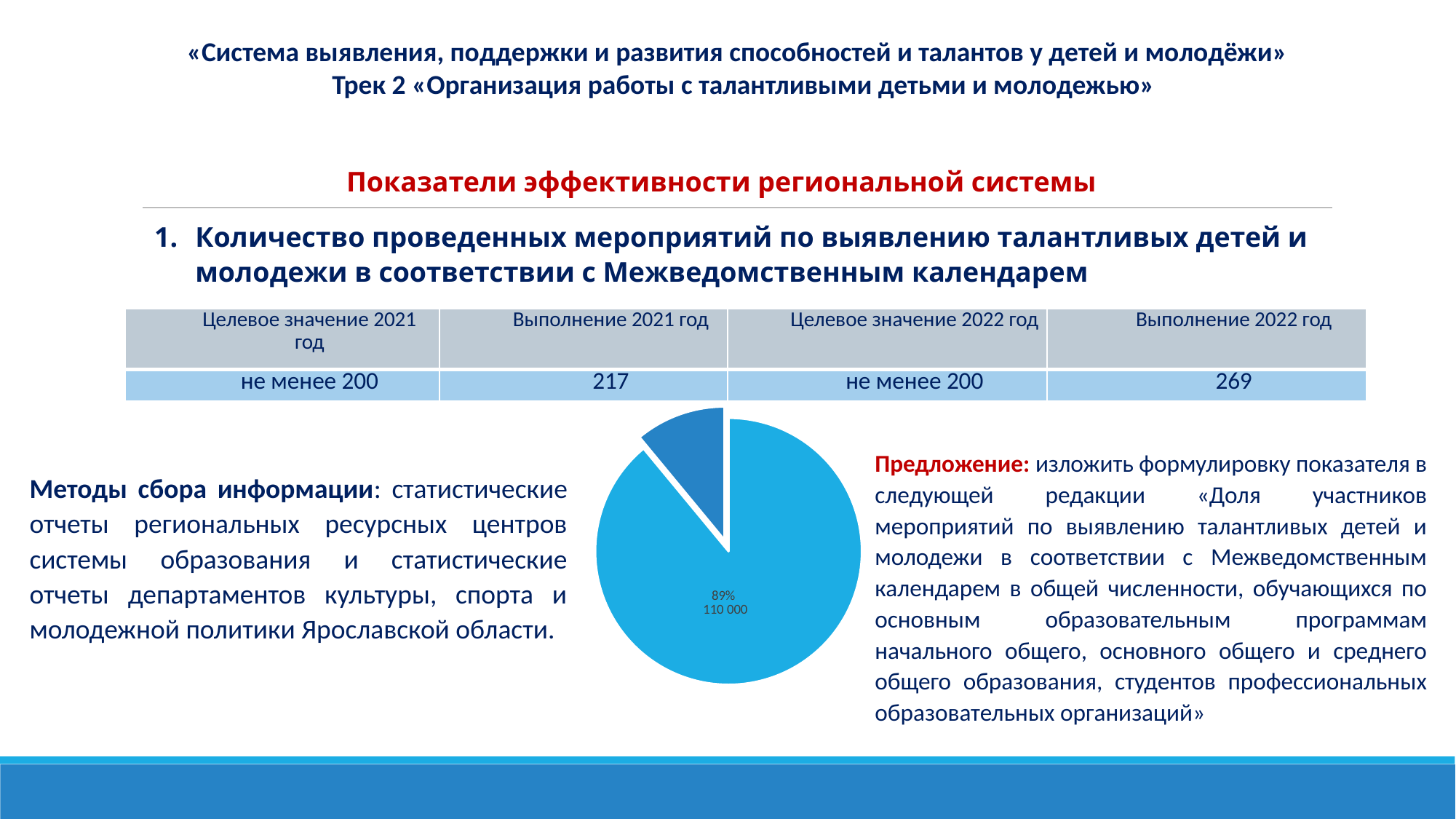
How many slices does the pie chart have? 2 What percentage is printed on the large slice of the pie chart? 89% What share of the pie does the large light-blue slice represent? 89% Does the pie chart have a legend? No Which slice of the pie chart is pulled out from the rest of the pie? the small dark-blue slice Which slice of the pie chart is larger, the light-blue one or the dark-blue one? the light-blue one What kind of chart is shown on the slide? pie chart Is the share of the large slice of the pie chart greater or less than 50%? greater What value is printed below the percentage on the large slice of the pie chart? 110 000